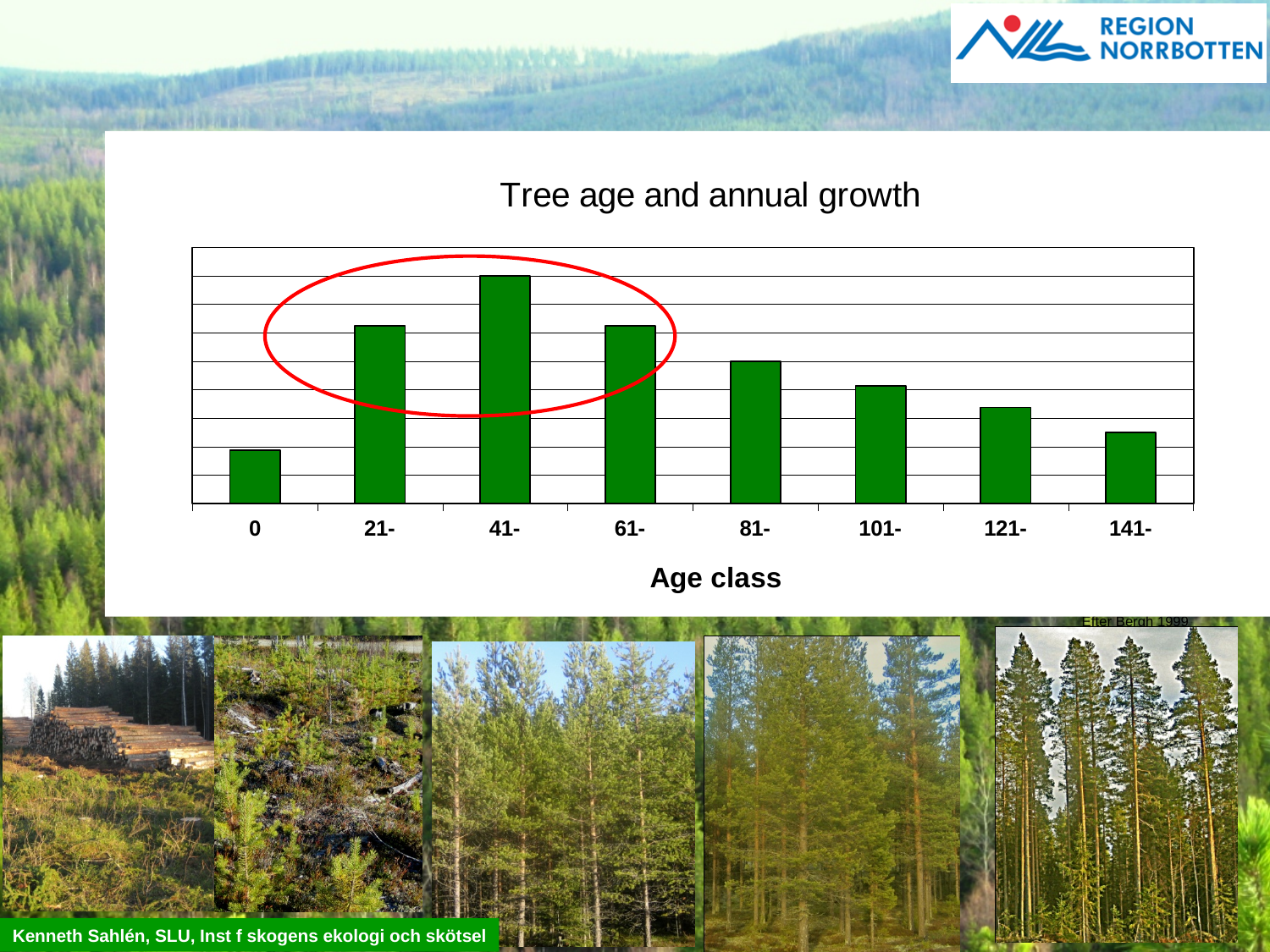
Which age class has the larger value, 41- or 81-? 41- What is the label of the x axis? Age class Which age class has the larger value, 0 or 141-? 141- How many age classes are shown on the x axis? 8 What is the title of the chart? Tree age and annual growth Which age class has the highest bar? 41- Which age class has the lowest bar? 0 Do the values rise or fall from the 41- age class to the 141- age class? fall What type of chart is shown on the slide? bar chart Do the values rise or fall from the 0 age class to the 41- age class? rise Which age class has the larger value, 121- or 141-? 121-